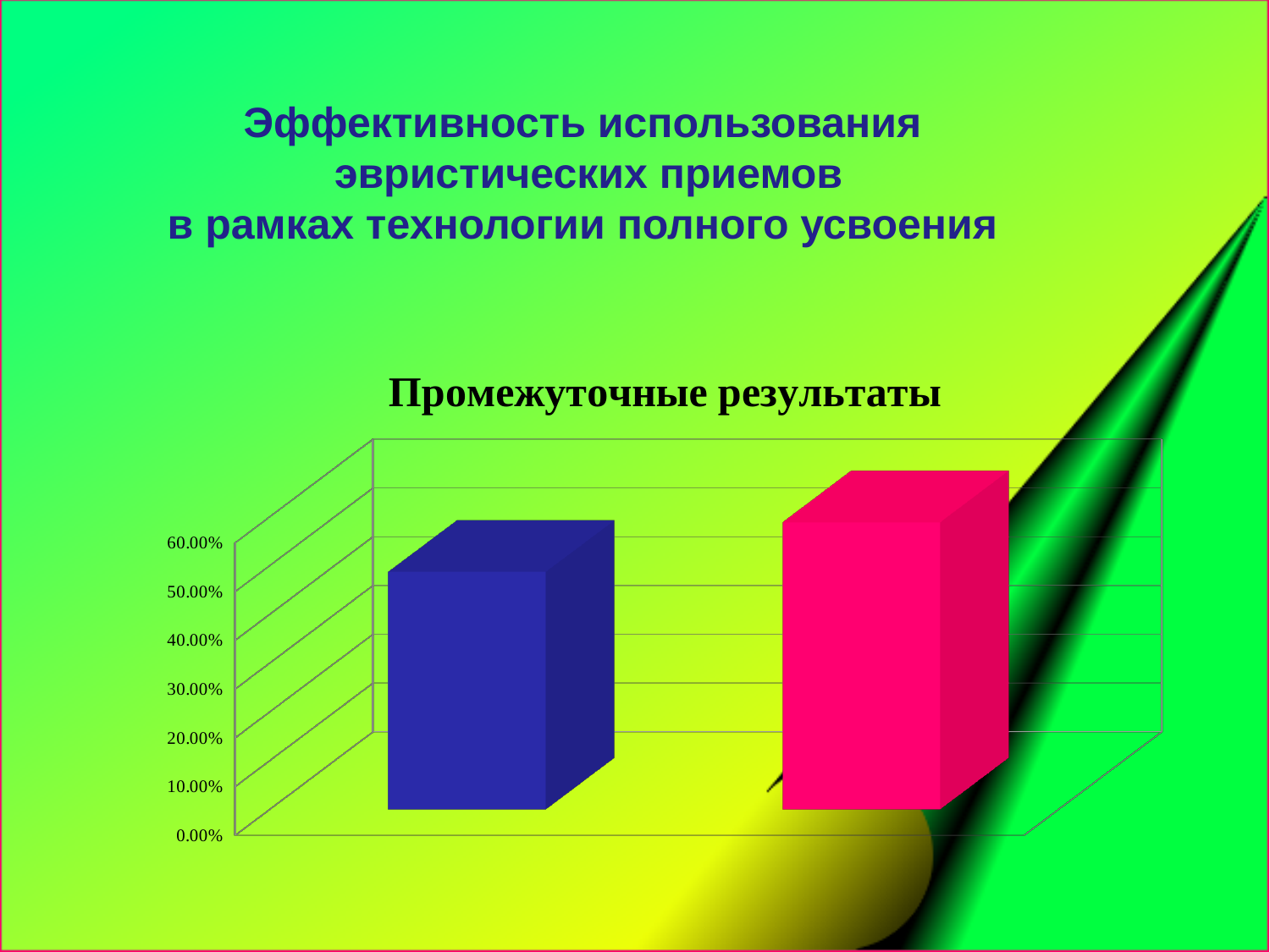
What is the highest value labelled on the vertical axis? 60.00% What kind of chart is shown on the slide? bar chart Which bar shows the highest value? the pink bar on the right Is the value of the blue bar on the left greater or less than 30.00%? greater Which bar is taller, the blue bar on the left or the pink bar on the right? the pink bar on the right What is the title of the chart? Промежуточные результаты Is the value of the pink bar on the right greater or less than 40.00%? greater Which bar shows the lowest value? the blue bar on the left Is the value of the blue bar on the left greater or less than 60.00%? less Do the values rise or fall from the left bar to the right bar? rise How many bars are plotted in the chart? 2